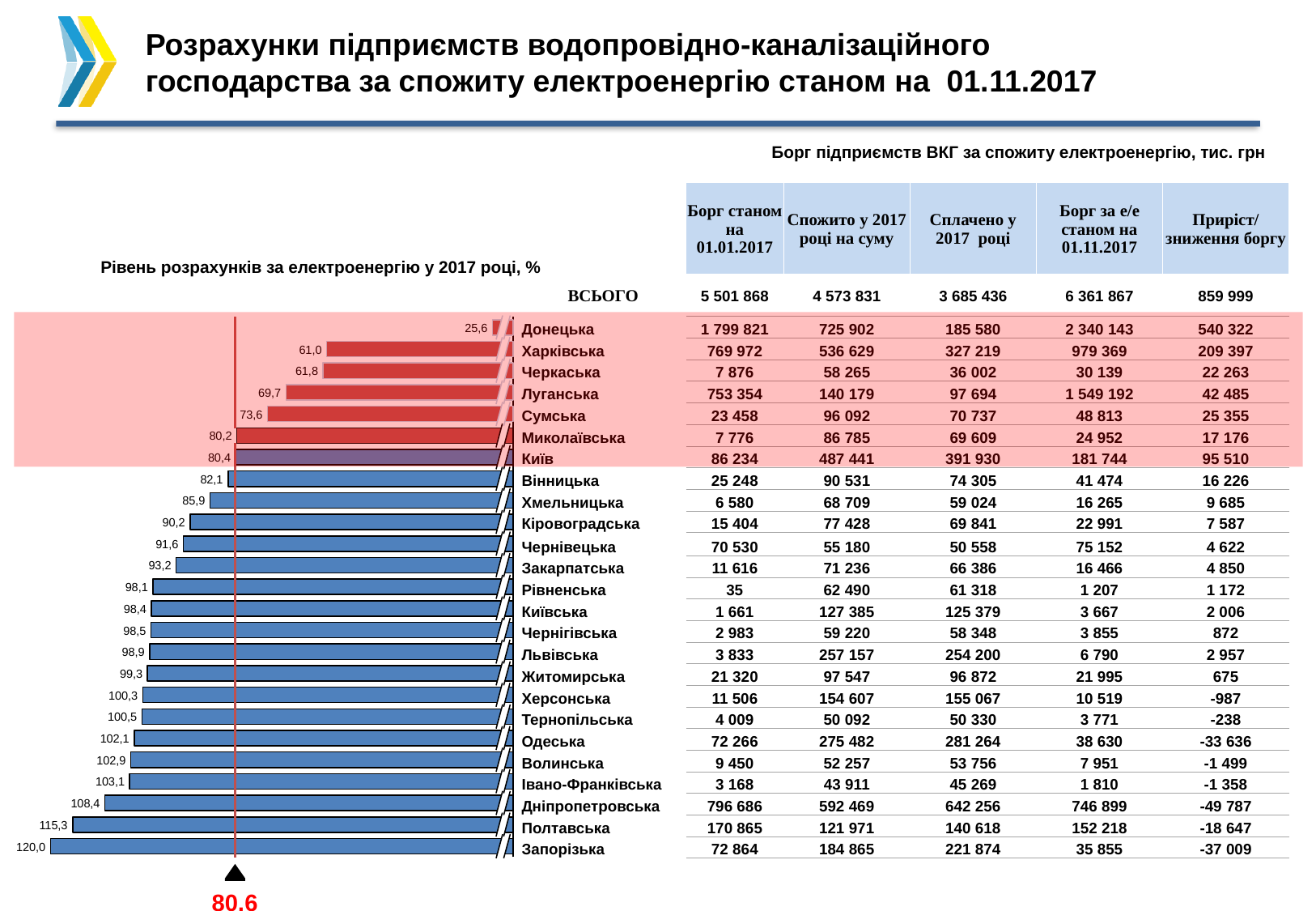
What is the value for Херсонська in the chart 'Рівень розрахунків за електроенергію у 2017 році, %'? 100,3 What is the value for Донецька in the chart 'Рівень розрахунків за електроенергію у 2017 році, %'? 25,6 What is the difference between the values for Луганська and Донецька in the chart 'Рівень розрахунків за електроенергію у 2017 році, %'? 44,1 Which has a larger value in the chart 'Рівень розрахунків за електроенергію у 2017 році, %': Харківська or Сумська? Сумська What value is marked by the red vertical line with the triangle below the chart 'Рівень розрахунків за електроенергію у 2017 році, %'? 80.6 What is the difference between the values for Полтавська and Дніпропетровська in the chart 'Рівень розрахунків за електроенергію у 2017 році, %'? 6,9 Which region has the lowest value in the chart 'Рівень розрахунків за електроенергію у 2017 році, %'? Донецька What type of chart is shown on the slide? bar chart What is the value for Запорізька in the chart 'Рівень розрахунків за електроенергію у 2017 році, %'? 120,0 How many regions (bars) are shown in the chart 'Рівень розрахунків за електроенергію у 2017 році, %'? 25 What is the value for Київ in the chart 'Рівень розрахунків за електроенергію у 2017 році, %'? 80,4 Which region has the highest value in the chart 'Рівень розрахунків за електроенергію у 2017 році, %'? Запорізька